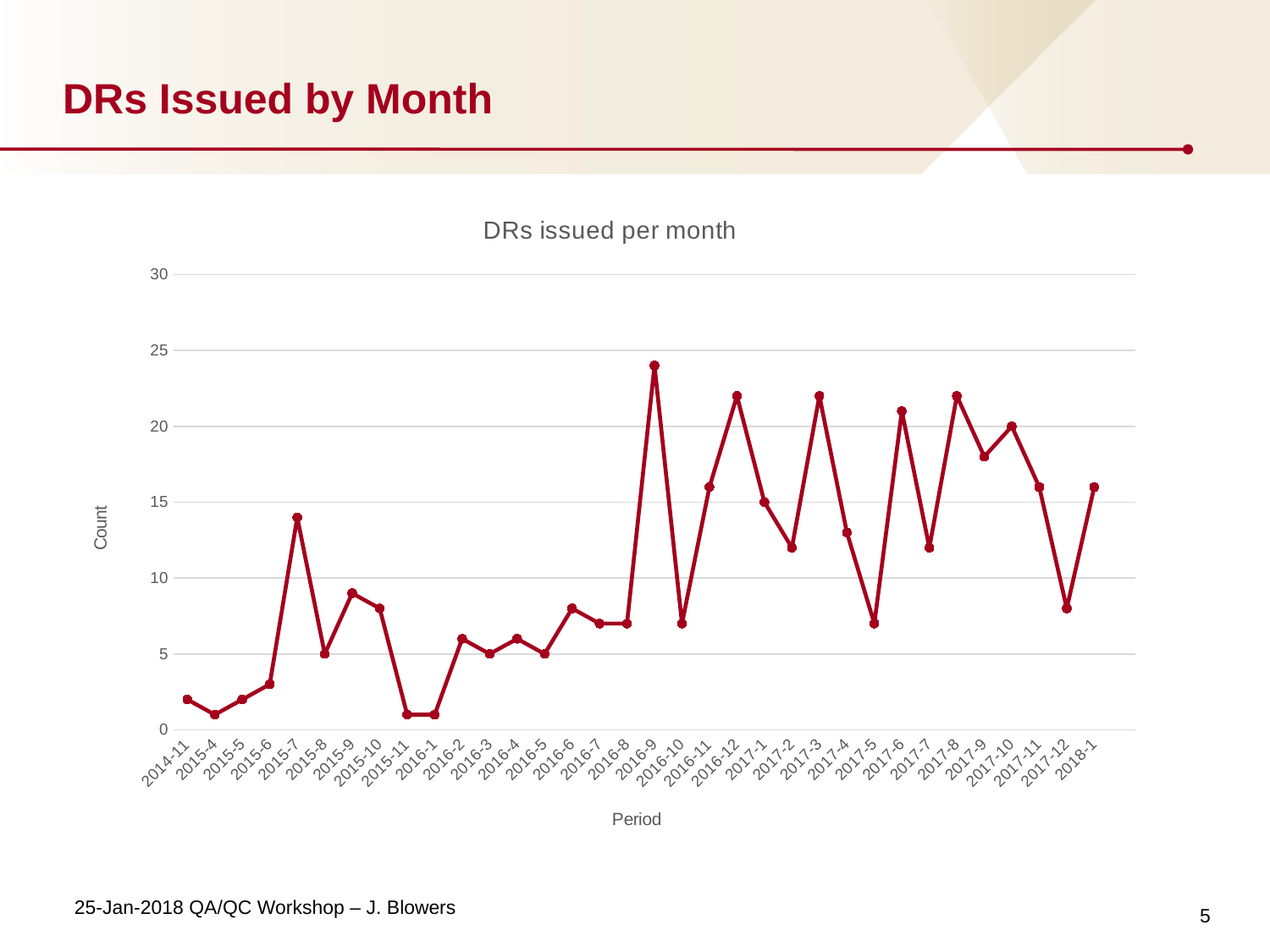
Which period has the highest count of DRs issued? 2016-9 How many periods are plotted along the x axis? 34 What is the count for 2017-10? 20 Is the value for 2015-7 greater or less than 10? greater Is the value for 2016-9 greater or less than 20? greater What kind of chart is shown on the slide? line chart Is the value for 2017-5 greater or less than 10? less What is the label on the y axis? Count What is the title of the chart? DRs issued per month Which period has the larger count, 2016-10 or 2016-12? 2016-12 Which period has the larger count, 2015-7 or 2015-8? 2015-7